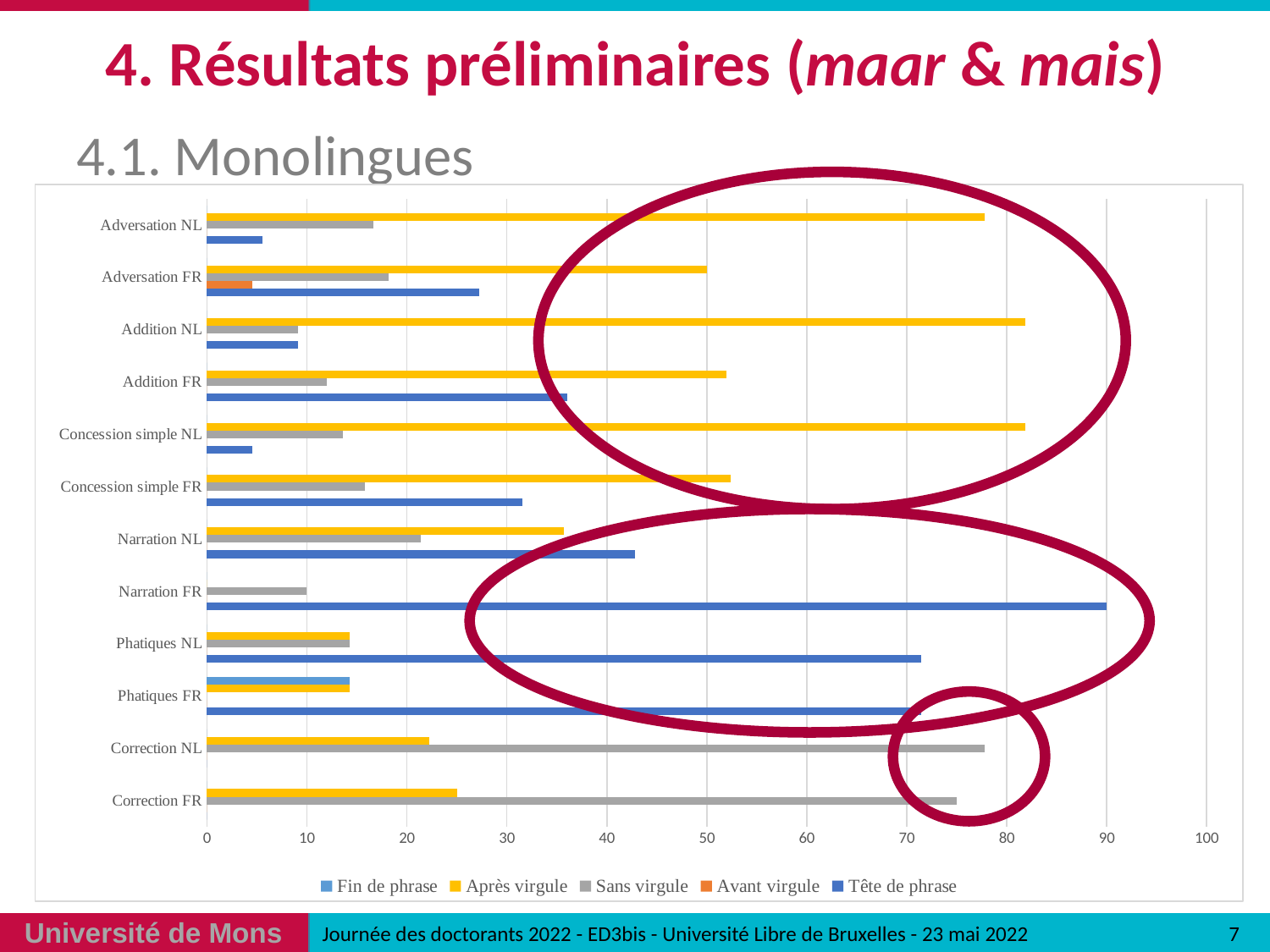
Is the value of Tête de phrase for Narration FR greater or less than 80? greater Is the value of Après virgule for Adversation FR greater or less than 40? greater Is the value of Tête de phrase for Adversation NL greater or less than 10? less Which series in the legend is shown in orange? Avant virgule Which category has the highest Tête de phrase value? Narration FR Which is larger for Concession simple NL: Après virgule or Sans virgule? Après virgule How many series does the chart legend list? 5 What kind of chart is shown on the slide? bar chart How many categories are listed on the vertical axis of the chart? 12 Which is larger for Narration NL: Après virgule or Tête de phrase? Tête de phrase